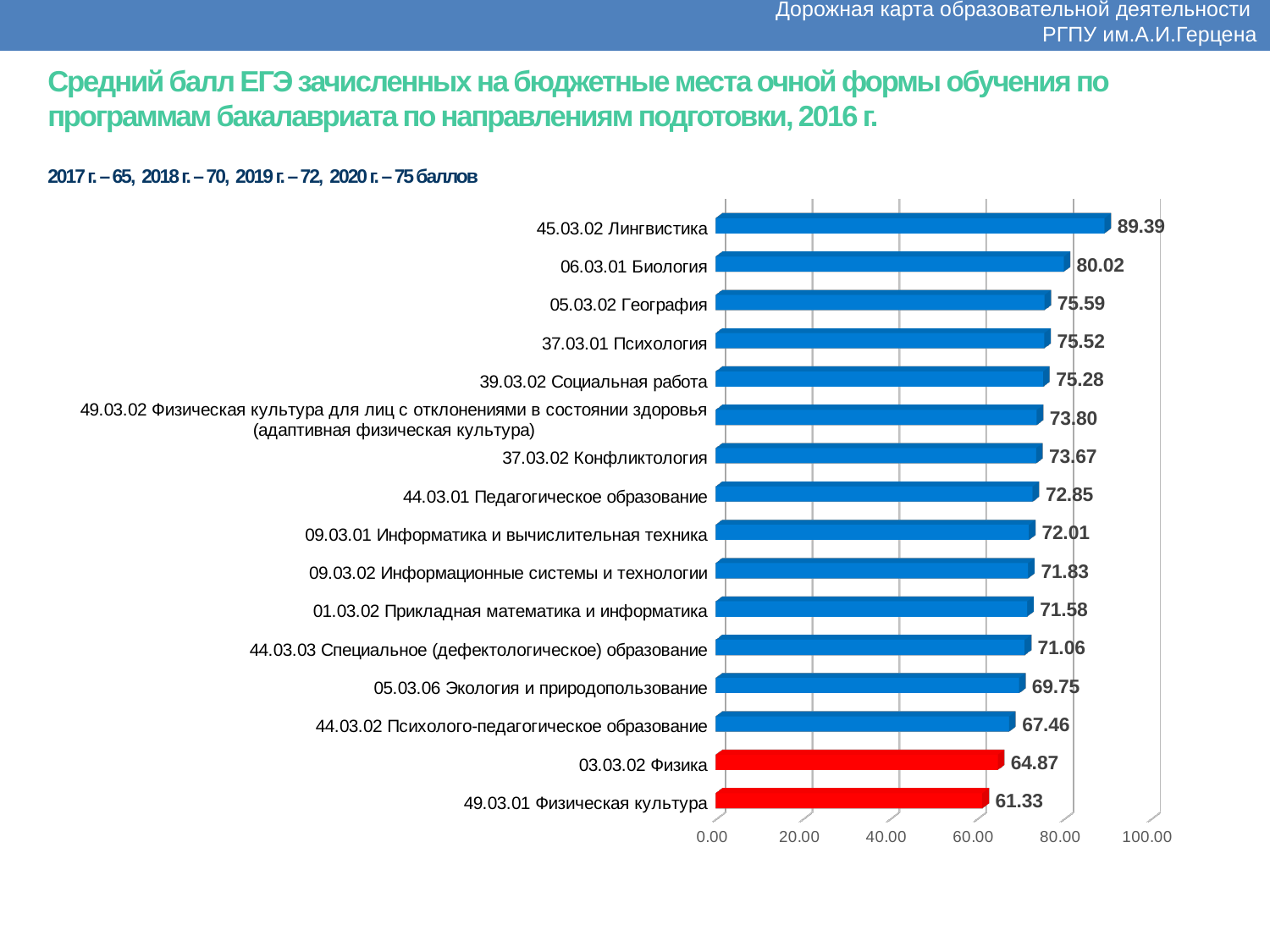
Which direction of study has the highest average score? 45.03.02 Лингвистика What is the value shown for 03.03.02 Физика? 64.87 What is the value shown for 44.03.01 Педагогическое образование? 72.85 Which direction of study has the lowest average score? 49.03.01 Физическая культура What is the average score for 45.03.02 Лингвистика? 89.39 Which has a higher value: 06.03.01 Биология or 05.03.06 Экология и природопользование? 06.03.01 Биология How many directions of study are shown in the chart? 16 Is the value for 03.03.02 Физика greater or less than 80.00? less What is the difference between the values for 45.03.02 Лингвистика and 49.03.01 Физическая культура? 28.06 What type of chart is shown on the slide? bar chart How many bars are coloured red in the chart? 2 What is the difference between the values for 06.03.01 Биология and 05.03.02 География? 4.43